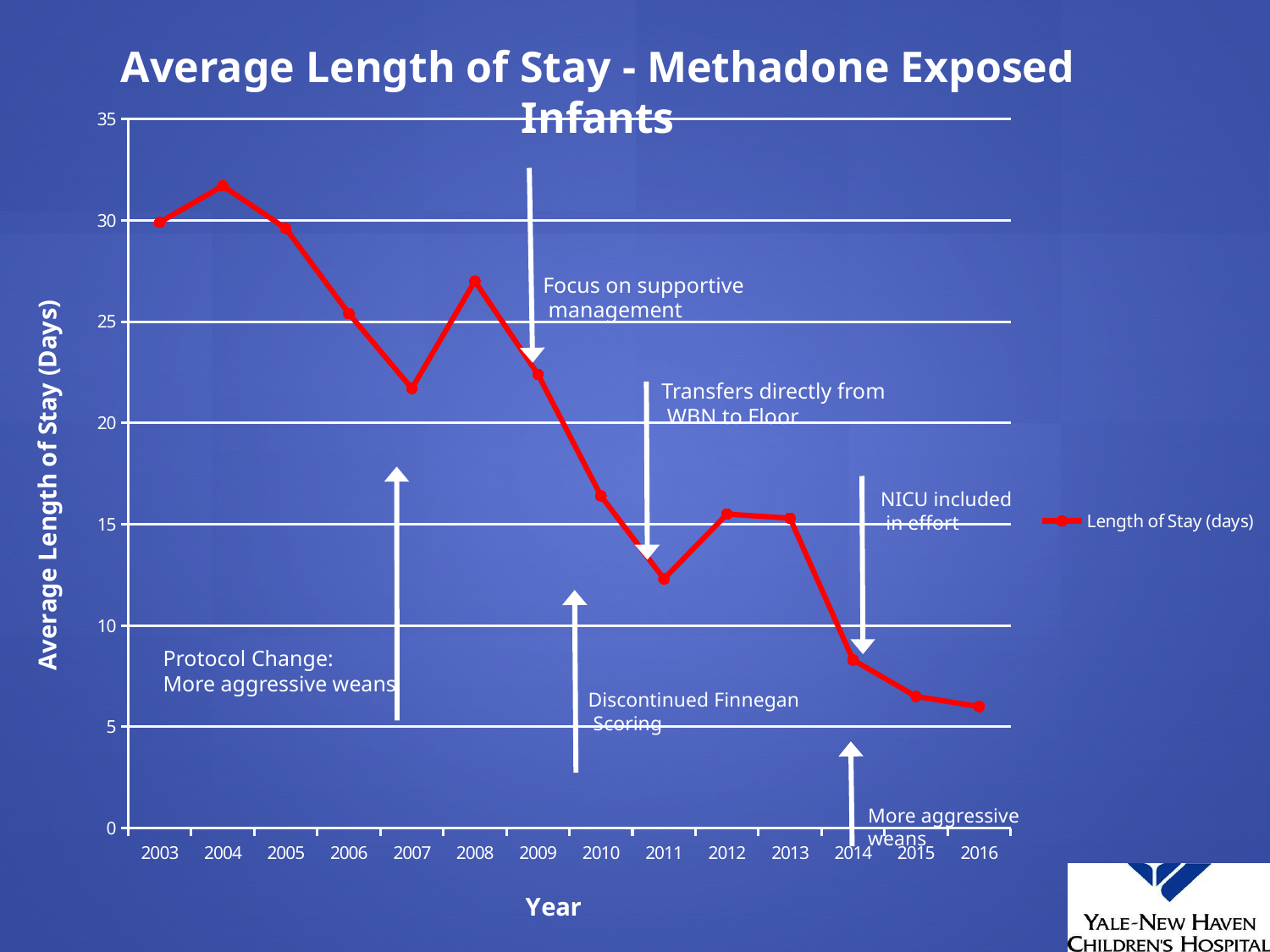
Is the value for 2007 greater or less than 25? less Which year has the larger value, 2007 or 2008? 2008 What kind of chart is shown on the slide? line chart Is the value for 2014 greater or less than 10? less What is the legend entry for the plotted series? Length of Stay (days) How many series does the legend list? 1 Is the value for 2011 greater or less than 15? less Which year has the larger value, 2011 or 2012? 2012 How many years are plotted along the x axis? 14 Which year has the highest average length of stay? 2004 Overall, do the values rise or fall from 2003 to 2016? fall